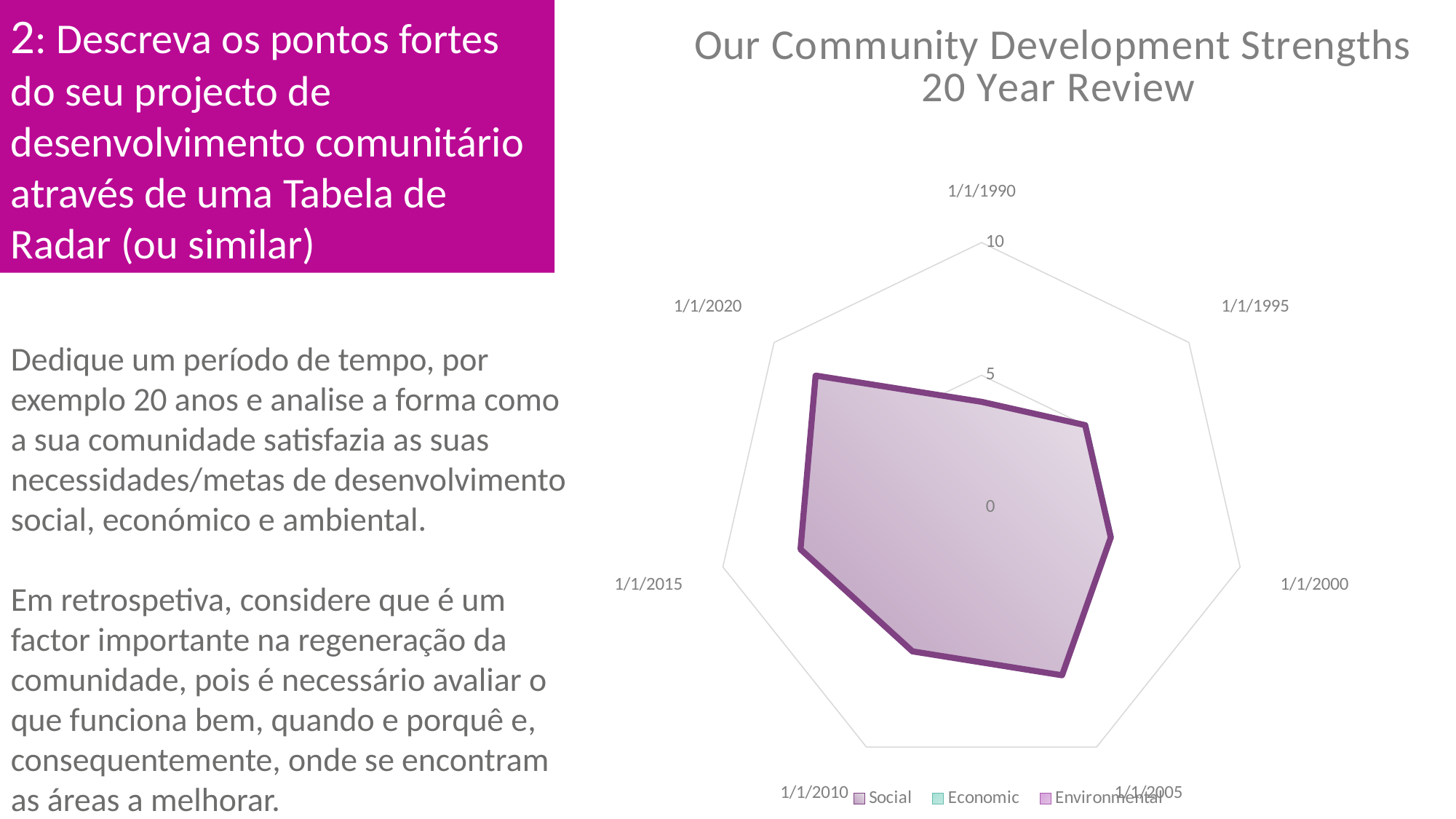
What are the series names listed in the chart legend? Social, Economic, Environmental How many categories (dates) are plotted around the radar chart? 7 Which has the larger value, 1/1/2020 or 1/1/2000? 1/1/2020 Is the value for 1/1/2020 greater or less than 5? greater Which has the larger value, 1/1/2005 or 1/1/1990? 1/1/2005 Which category has the highest plotted value? 1/1/2020 Is the value for 1/1/2015 greater or less than 5? greater What kind of chart is shown on the slide? Radar chart Is the value for 1/1/2005 greater or less than 5? greater How many series does the chart legend list? 3 What is the title of the chart? Our Community Development Strengths 20 Year Review